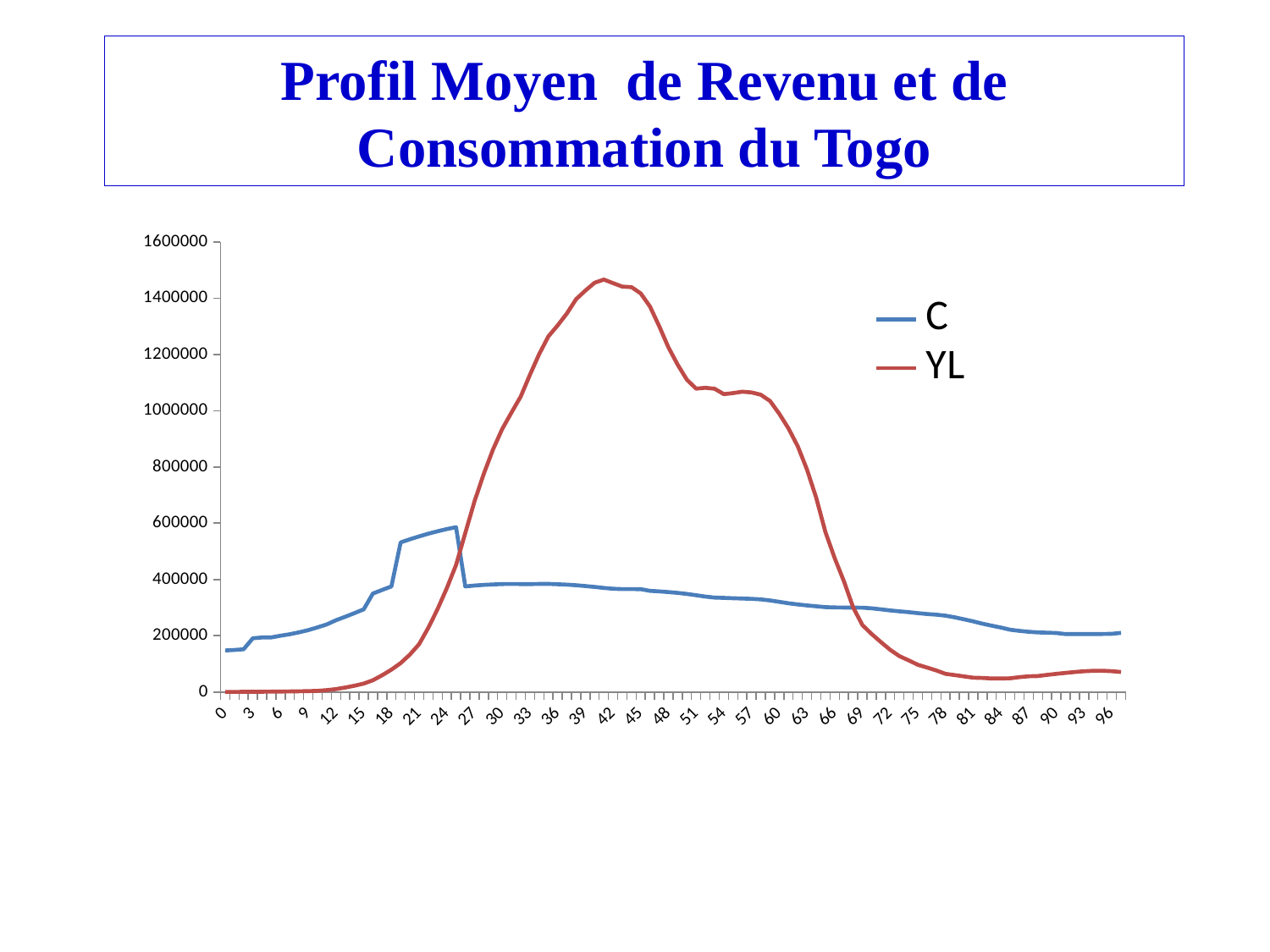
How many series does the legend list? 2 At x = 42, which series has the larger value, C or YL? YL What is the title of the slide containing the chart? Profil Moyen de Revenu et de Consommation du Togo At x = 0, which series has the larger value, C or YL? C Is the value of C at x = 0 greater or less than 200000? less What are the two series named in the legend? C and YL Is the value of YL at x = 42 greater or less than 1400000? greater Which series reaches the highest value on the chart? YL Does the YL series rise or fall between x = 27 and x = 42? rise Is the value of YL at x = 84 greater or less than 200000? less What kind of chart is shown on the slide? line chart